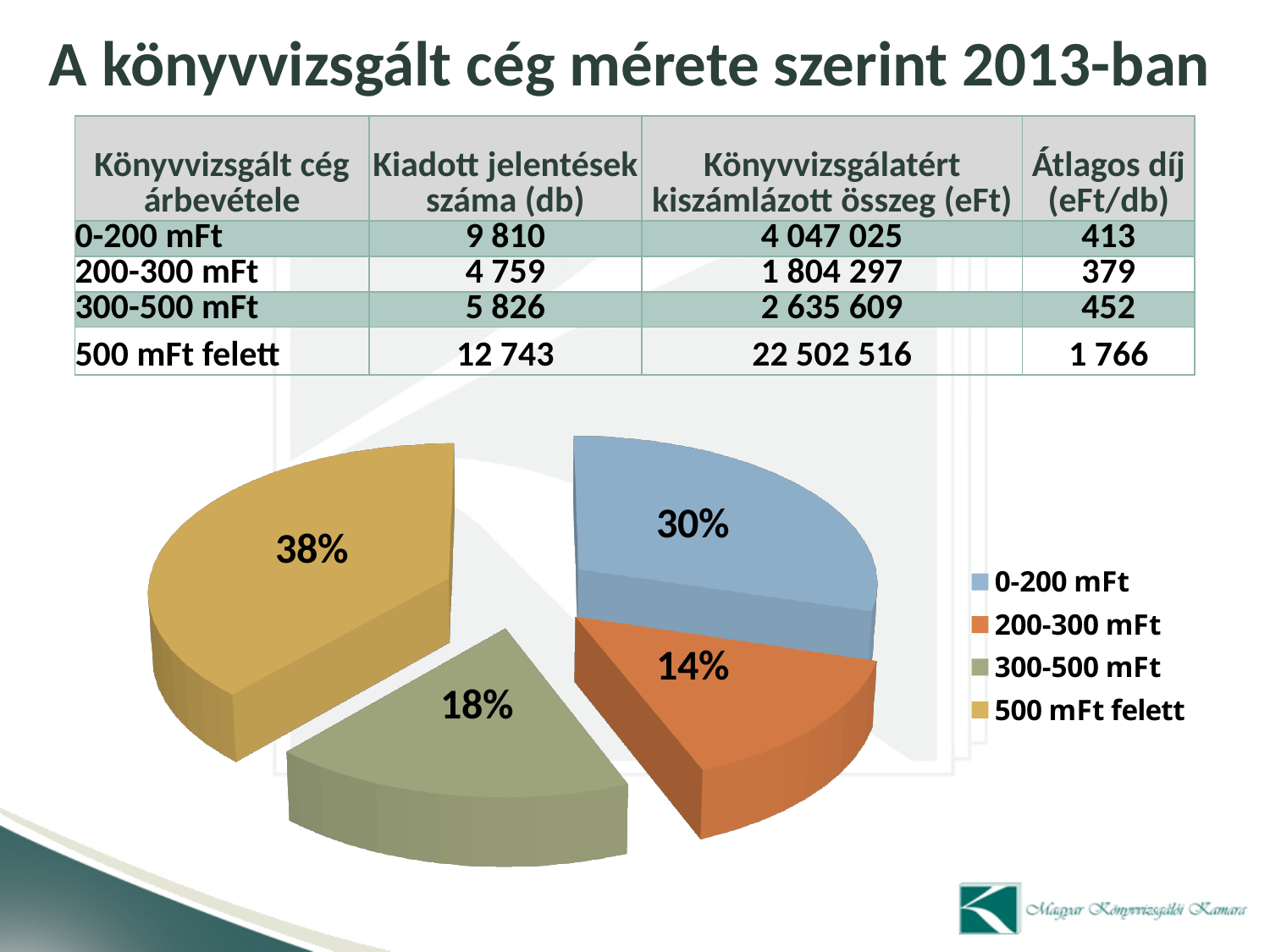
What is the difference in percentage points between the 300-500 mFt slice and the 200-300 mFt slice? 4 What is the difference in percentage points between the 500 mFt felett slice and the 0-200 mFt slice? 8 What share of the pie chart does the 300-500 mFt slice represent? 18% What colour is the 500 mFt felett slice in the pie chart? Yellow What type of chart is shown on the slide? Pie chart What share of the pie chart does the 500 mFt felett slice represent? 38% What share of the pie chart does the 0-200 mFt slice represent? 30% How many slices does the pie chart have? 4 Which slice is larger in the pie chart: 0-200 mFt or 300-500 mFt? 0-200 mFt Which category has the largest slice in the pie chart? 500 mFt felett Which category has the smallest slice in the pie chart? 200-300 mFt